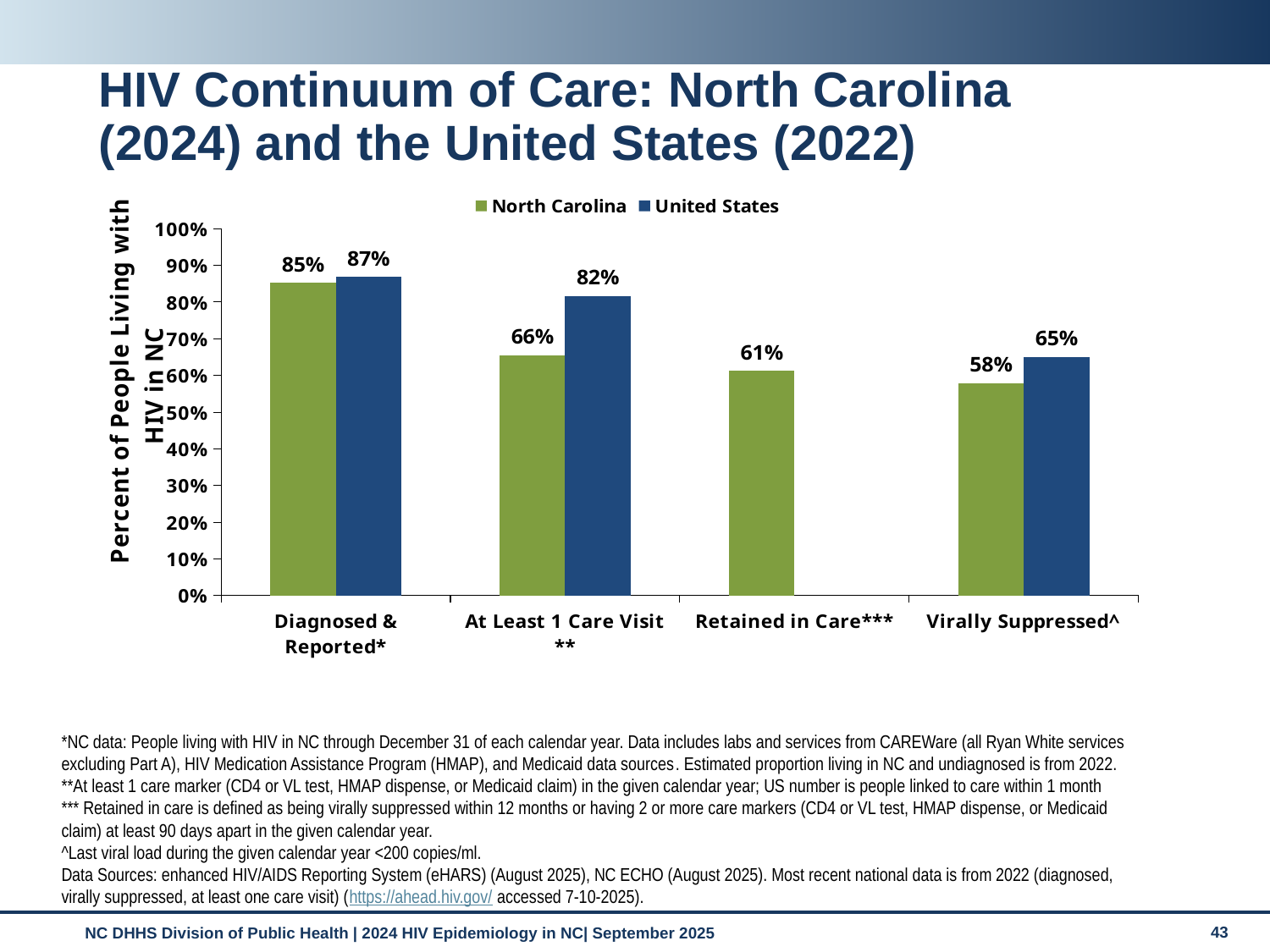
Which category has the lowest North Carolina value? Virally Suppressed^ What kind of chart is shown on the slide? Bar chart What is the difference between the United States and North Carolina values for At Least 1 Care Visit**? 16% Which is larger for Virally Suppressed^: the North Carolina value or the United States value? United States Which category has no United States bar? Retained in Care*** What is the North Carolina value for Diagnosed & Reported*? 85% How many categories are shown on the x axis? 4 How many series does the legend list? 2 What is the North Carolina value for Retained in Care***? 61% What is the United States value for Virally Suppressed^? 65% Which category has the highest United States value? Diagnosed & Reported* What is the United States value for At Least 1 Care Visit**? 82%